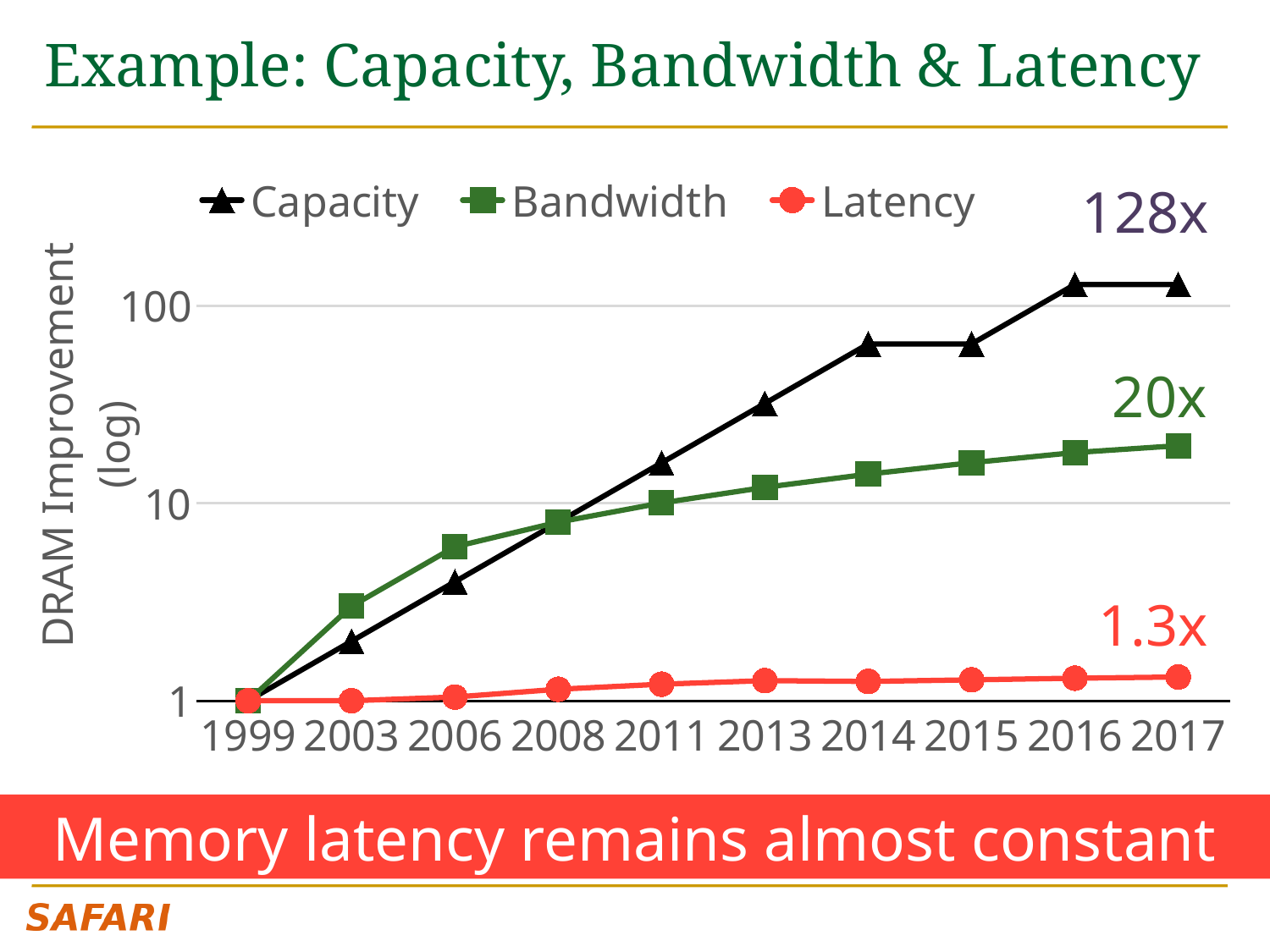
In 2006, which is larger: Capacity or Bandwidth? Bandwidth Which series has the highest value in 2017? Capacity What kind of chart is shown on the slide? line chart How many years are shown along the x axis? 10 What is the DRAM improvement for Capacity in 2017, as labelled on the chart? 128x What is the DRAM improvement for Bandwidth in 2017, as labelled on the chart? 20x What is the DRAM improvement for Latency in 2017, as labelled on the chart? 1.3x Which series has the lowest value in 2017? Latency How many series does the legend list? 3 Is the value for Capacity in 2013 greater or less than 10? greater Does the Capacity series rise or fall from 1999 to 2017? rise Is the value for Bandwidth in 2008 greater or less than 10? less